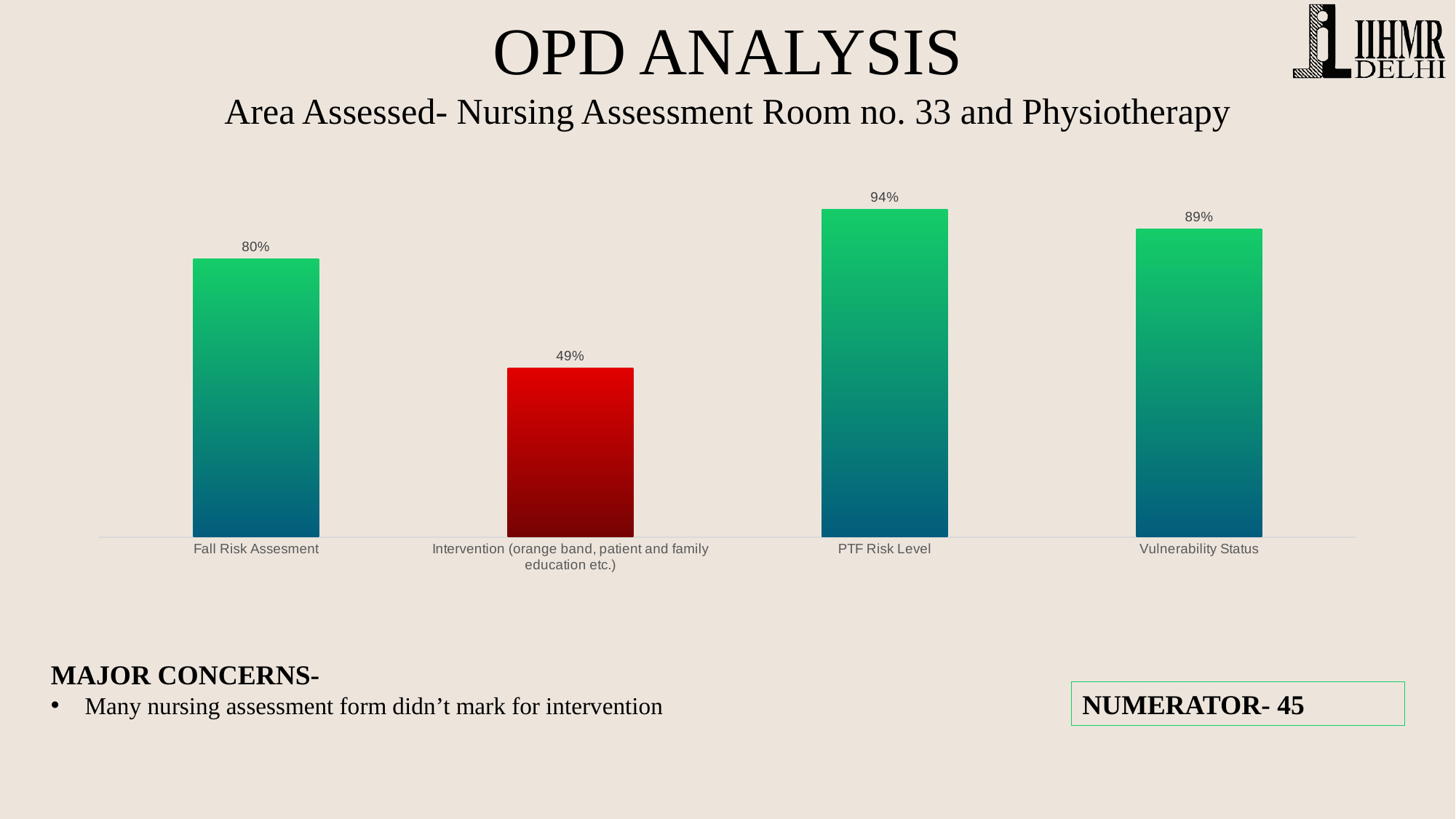
What is the difference between the values for PTF Risk Level and Vulnerability Status? 5% Which category has the highest value? PTF Risk Level What is the value for PTF Risk Level? 94% Which bar is coloured red instead of green? Intervention (orange band, patient and family education etc.) What is the value for Vulnerability Status? 89% What kind of chart is shown on the slide? Bar chart What is the difference between the values for Fall Risk Assesment and Intervention (orange band, patient and family education etc.)? 31% What is the value for Fall Risk Assesment? 80% How many categories are shown in the chart? 4 Which is larger, the value for Fall Risk Assesment or the value for Vulnerability Status? Vulnerability Status What is the value for Intervention (orange band, patient and family education etc.)? 49% Which category has the lowest value? Intervention (orange band, patient and family education etc.)